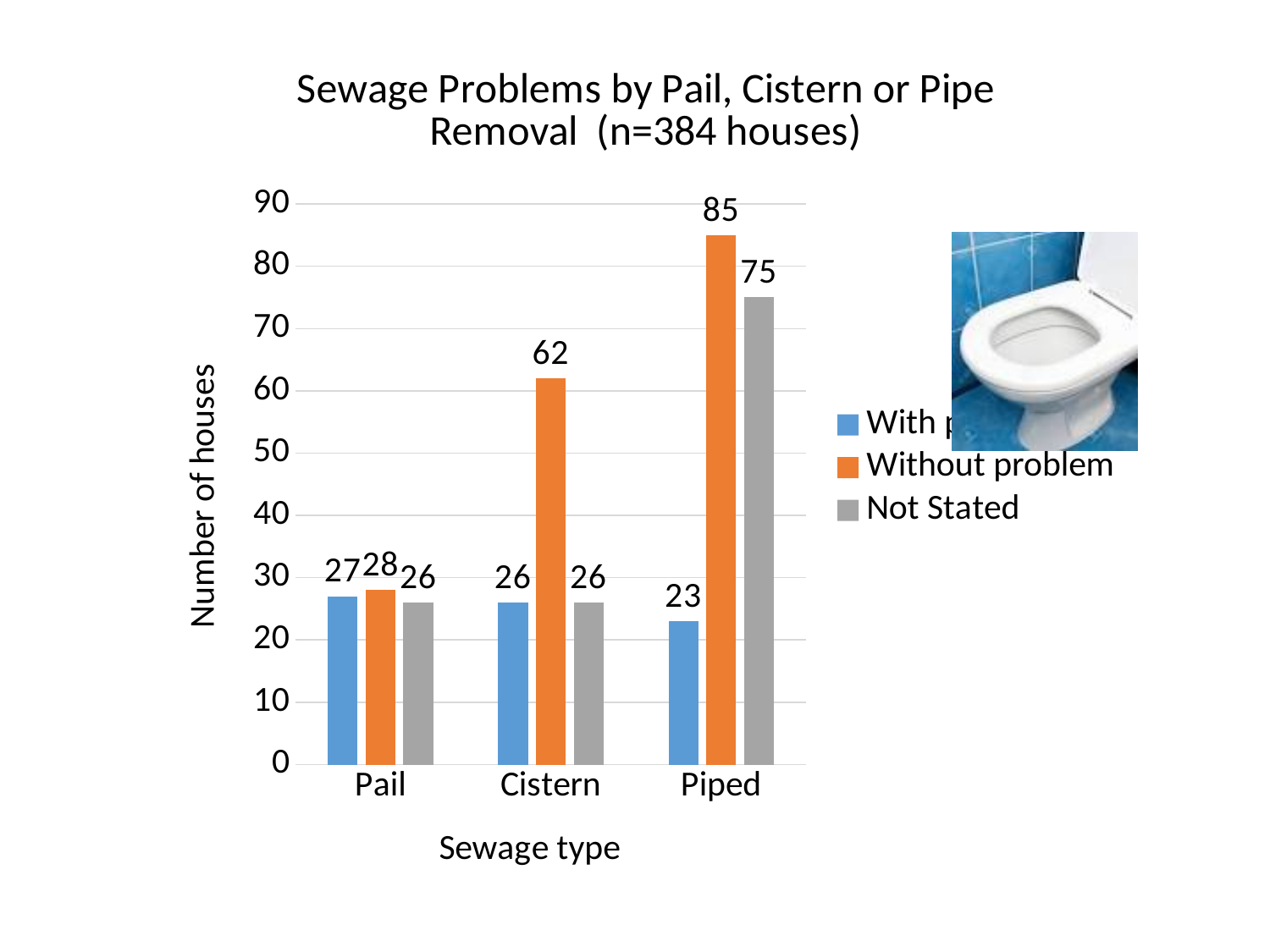
What is the difference between the Without problem values for Piped and Cistern? 23 What is the value for Not Stated in the Piped category? 75 What is the value for Not Stated in the Cistern category? 26 Is the Without problem value for Cistern greater or less than 60? greater Which sewage type has the highest Without problem value? Piped Which is larger in the Piped category: Without problem or Not Stated? Without problem How many sewage type categories are shown on the x axis? 3 What kind of chart is shown on the slide? Bar chart How many series does the legend list? 3 What is the value for Without problem in the Pail category? 28 What is the value for Without problem in the Piped category? 85 Which sewage type has the lowest Not Stated value? Pail and Cistern (both 26)